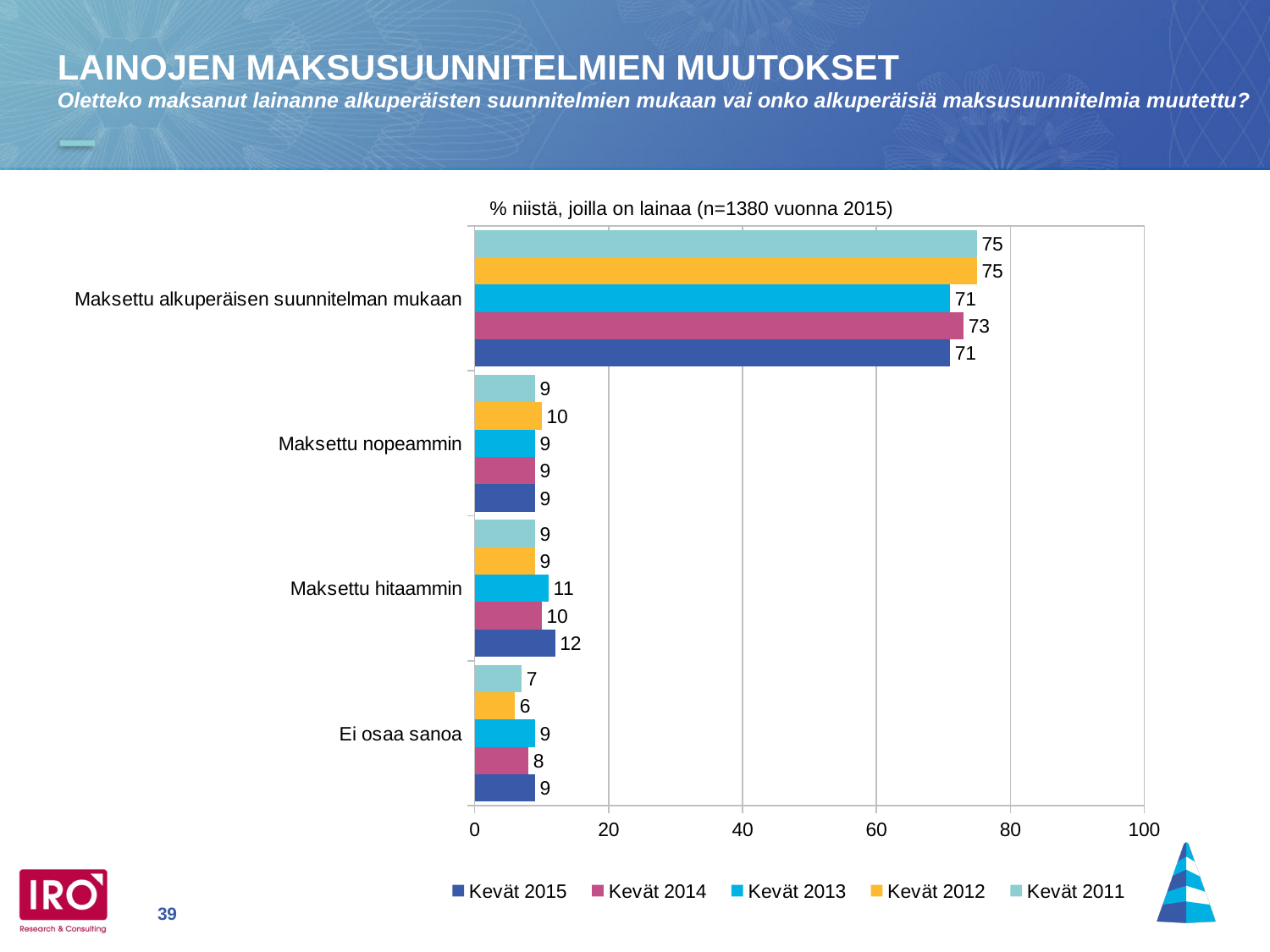
Which series has the lowest value in the category 'Ei osaa sanoa'? Kevät 2012 How many series does the legend list? 5 What is the title shown above the chart? % niistä, joilla on lainaa (n=1380 vuonna 2015) Which category has the highest value for Kevät 2013? Maksettu alkuperäisen suunnitelman mukaan What is the value for Kevät 2012 in the category 'Ei osaa sanoa'? 6 What is the value for Kevät 2015 in the category 'Maksettu hitaammin'? 12 Which is larger in the category 'Maksettu hitaammin': the value for Kevät 2015 or the value for Kevät 2011? Kevät 2015 What is the value for Kevät 2015 in the category 'Maksettu alkuperäisen suunnitelman mukaan'? 71 What kind of chart is shown on the slide? bar chart What is the difference between the Kevät 2011 and Kevät 2015 values in the category 'Maksettu alkuperäisen suunnitelman mukaan'? 4 What is the value for Kevät 2014 in the category 'Maksettu alkuperäisen suunnitelman mukaan'? 73 How many categories are shown on the chart? 4